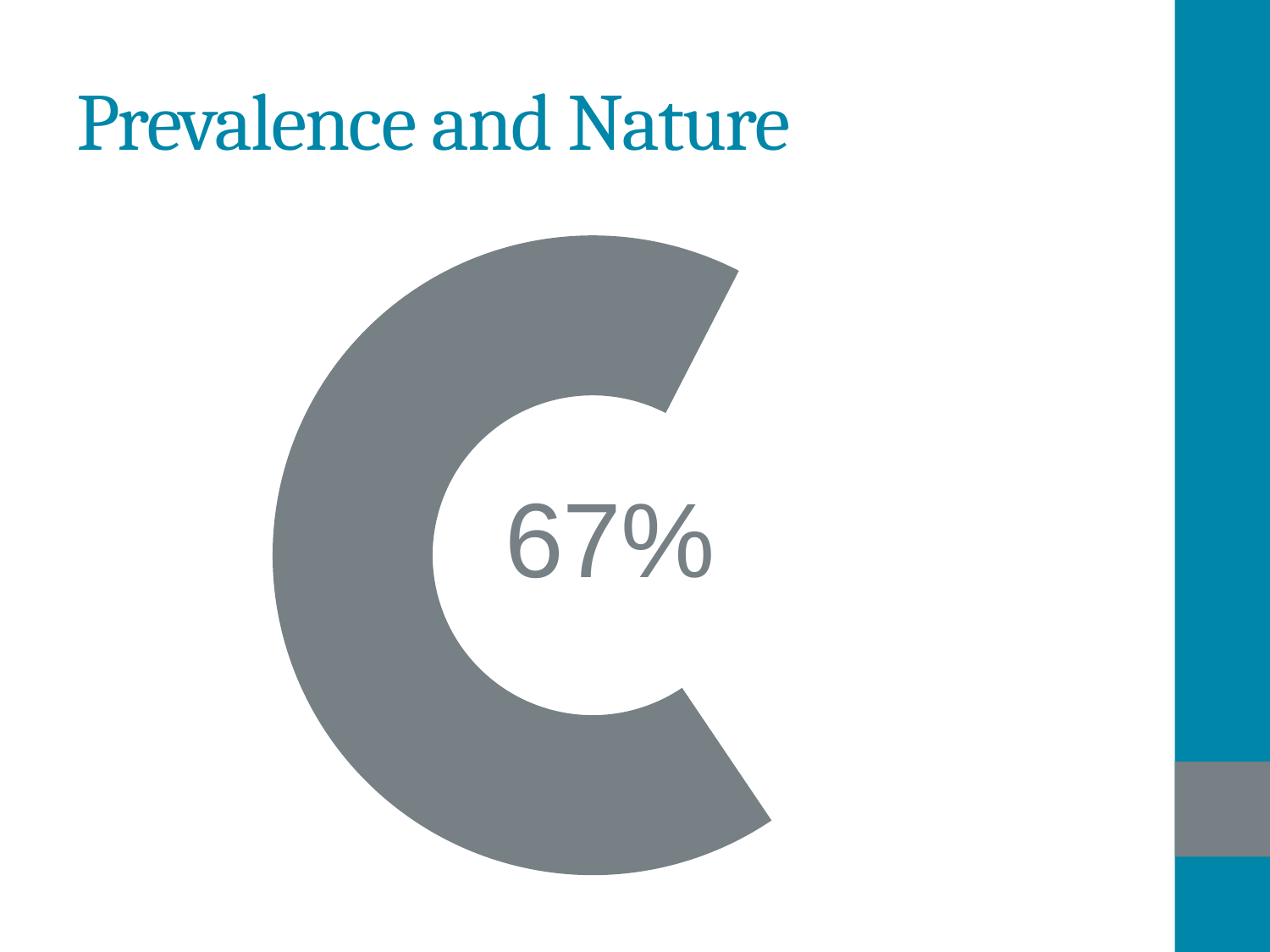
What share of the doughnut does the grey segment represent? 67% Is the value shown on the doughnut chart greater or less than 50%? greater What colour is the filled segment of the doughnut chart? Grey What kind of chart is shown on the slide? Doughnut chart What is the title of the slide containing the doughnut chart? Prevalence and Nature What percentage is printed in the centre of the doughnut chart? 67%